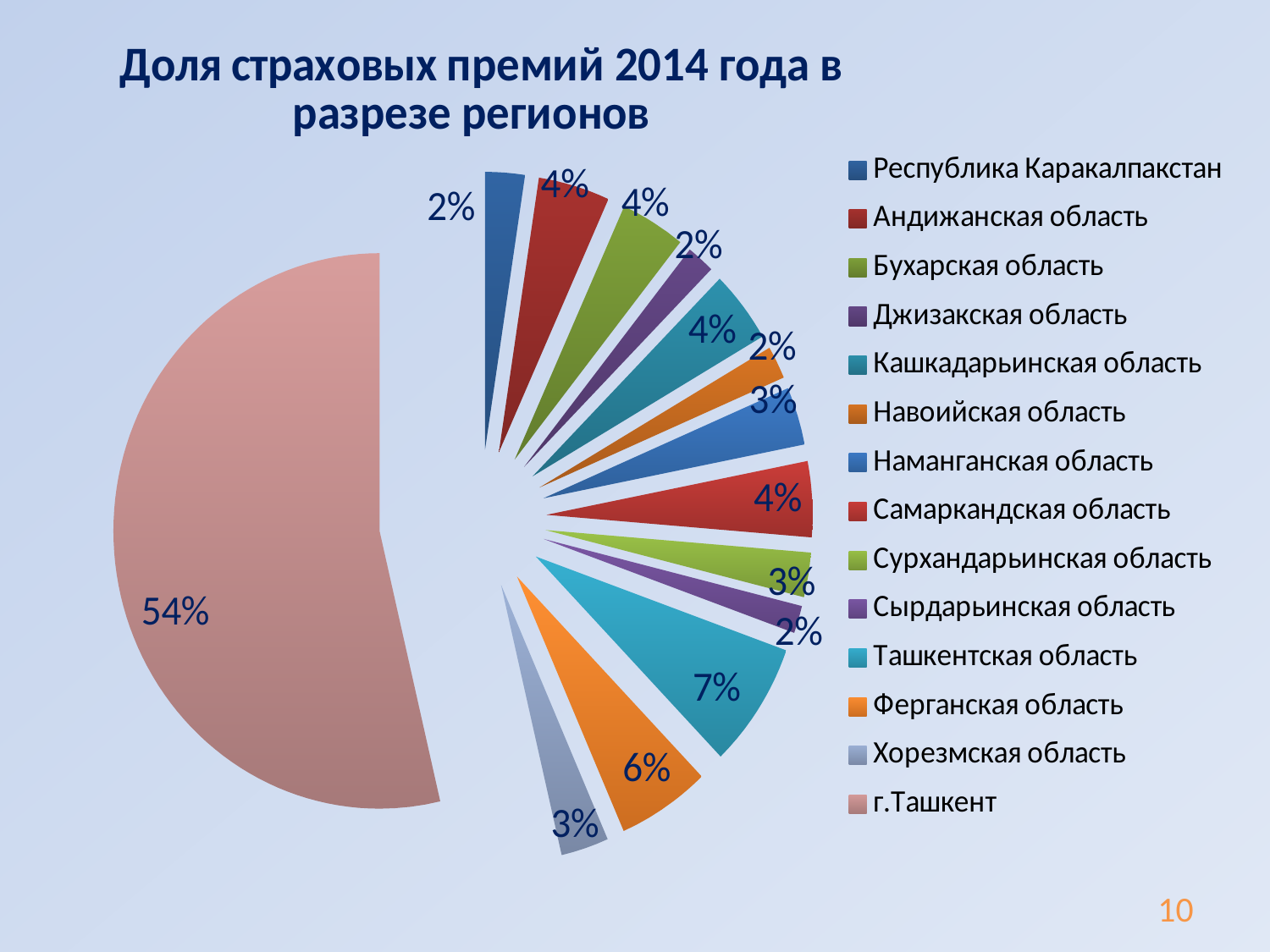
What is the share for г.Ташкент? 54% Which region has the largest share of insurance premiums? г.Ташкент How many regions are listed in the legend? 14 What is the difference between the share for Ферганская область and the share for Хорезмская область? 3% What is the share for Республика Каракалпакстан? 2% What is the share for Ташкентская область? 7% What is the share for Хорезмская область? 3% Which is larger, the share for Ташкентская область or the share for Ферганская область? Ташкентская область What kind of chart is shown on the slide? pie chart What is the share for Ферганская область? 6% What is the title of the chart? Доля страховых премий 2014 года в разрезе регионов What is the difference between the share for г.Ташкент and the share for Ташкентская область? 47%